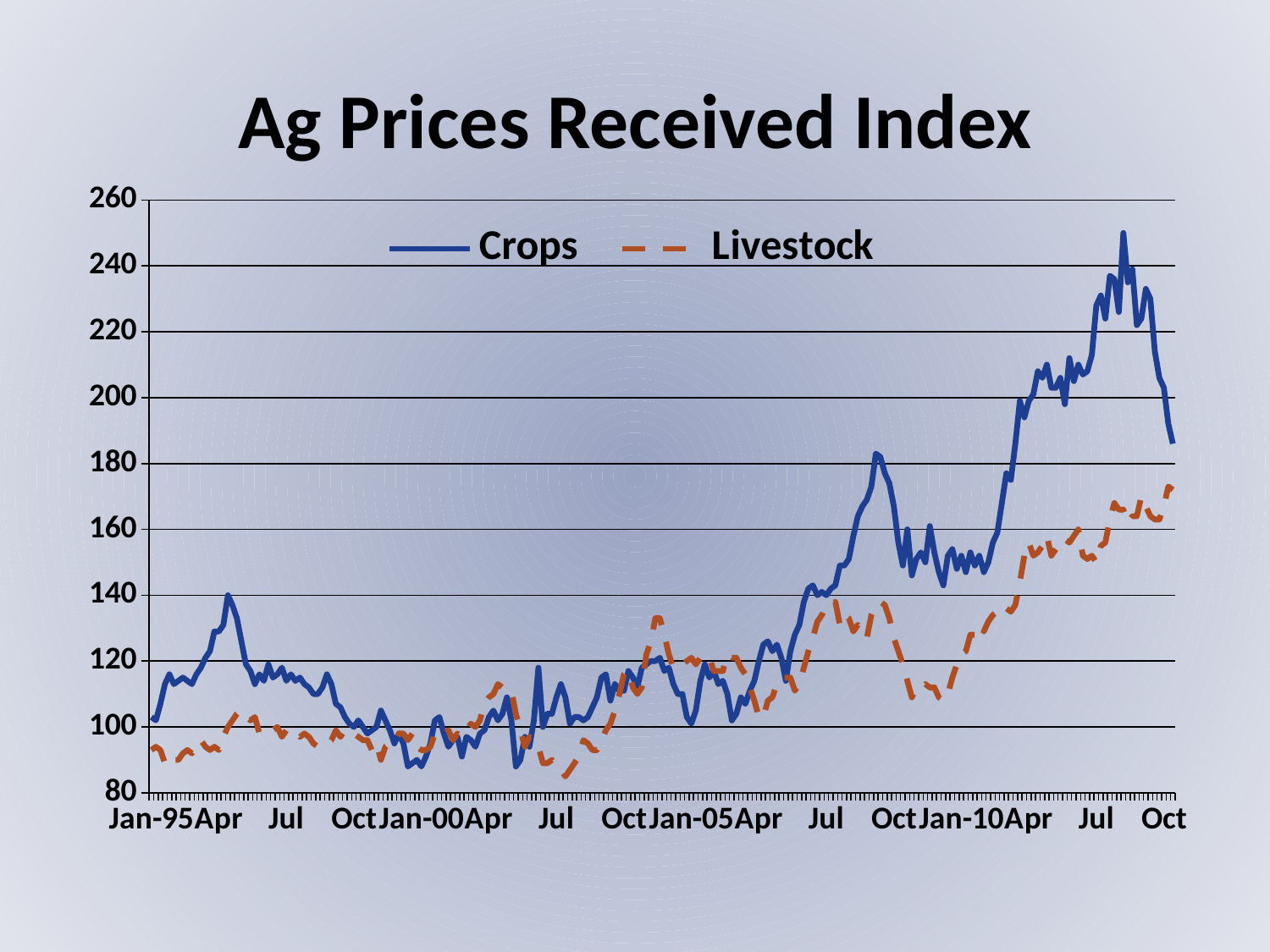
How many series does the legend list? 2 Is the peak value of the Crops series greater or less than 240? greater Is the highest value of the Livestock series greater or less than 180? less At Jan-10, which series has the higher value, Crops or Livestock? Crops What kind of chart is shown on the slide? line chart Which series reaches the highest value on the chart? Crops Is the value for Crops at Jan-10 greater or less than 140? greater At the last point on the x axis (Oct), which series has the higher value, Crops or Livestock? Crops Overall, do the Crops values rise or fall from Jan-95 to the end of the x axis? rise Which series is drawn with a dashed line? Livestock What is the title of the chart? Ag Prices Received Index